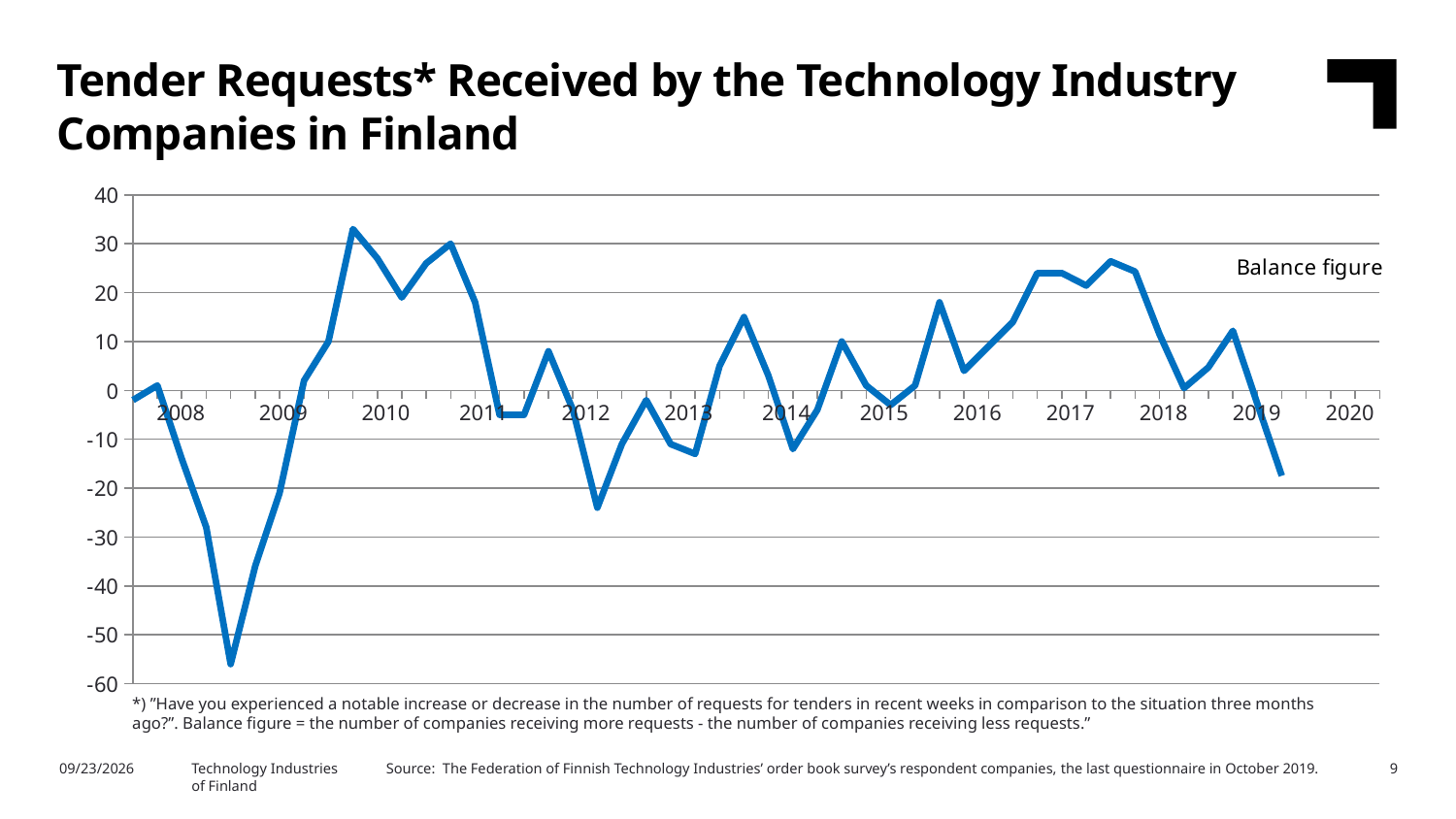
Is the lowest value of the balance figure on the chart greater or less than -50? less Is the last plotted value of the balance figure (end of 2019) greater or less than -10? less How many year labels are shown on the x axis? 13 How many data series are plotted in the chart? 1 Is the highest value of the balance figure on the chart greater or less than 30? greater Does the balance figure rise or fall between 2009 and 2010? rise What label is shown next to the line in the chart? Balance figure What is the title of the chart? Tender Requests* Received by the Technology Industry Companies in Finland What kind of chart is shown on the slide? line chart Does the balance figure rise or fall between 2018 and the end of 2019? fall